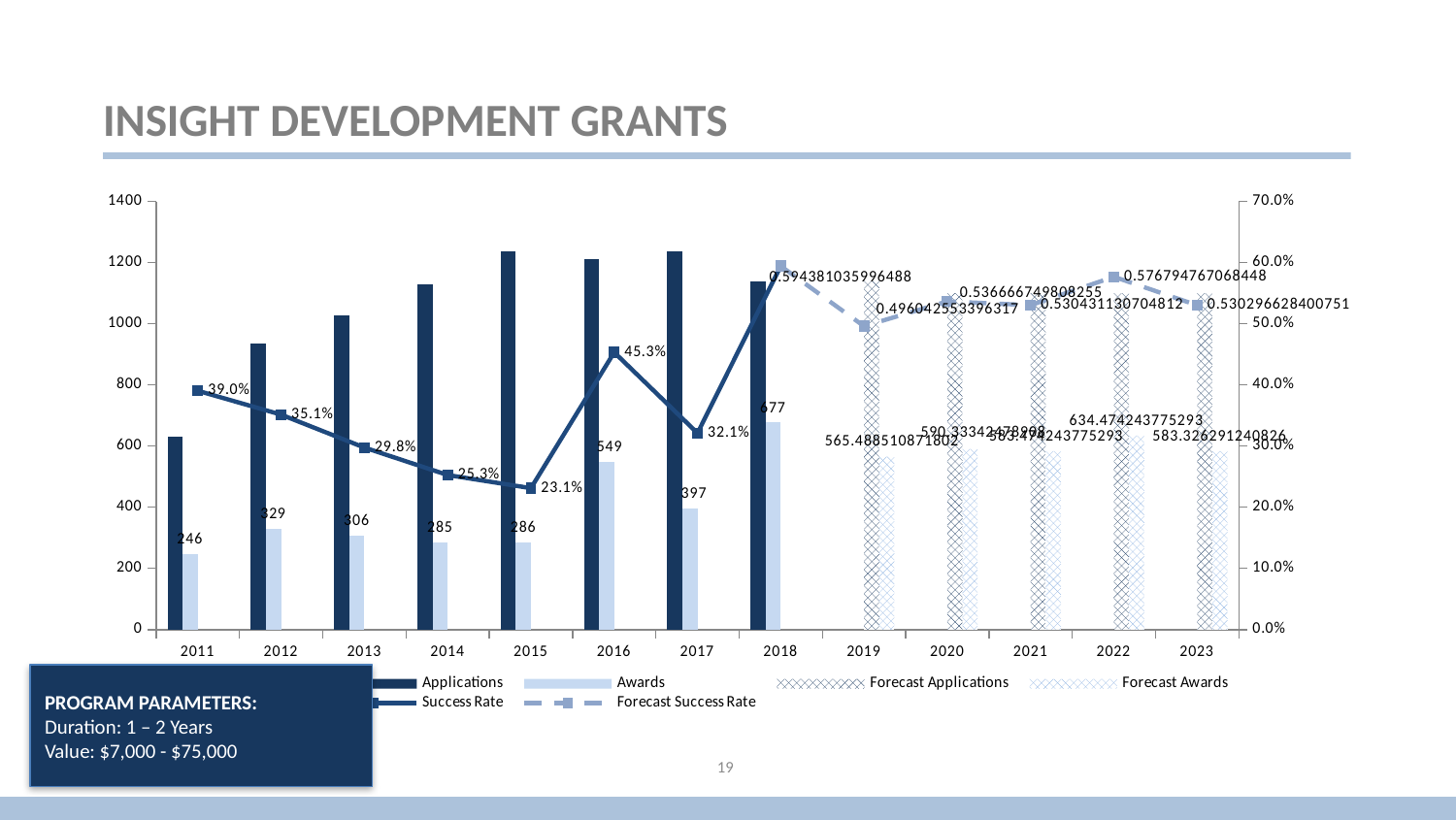
What is the difference between the Awards values for 2018 and 2017? 280 What is the Success Rate for 2016? 45.3% How many years are shown on the x axis? 13 Which year has the lowest Success Rate? 2015 Is the value for Applications in 2011 greater or less than 800? less What is the value for Awards in 2016? 549 Does the Success Rate rise or fall from 2011 to 2015? fall What is the Forecast Success Rate value shown for 2022? 0.576794767068448 What is the value for Awards in 2018? 677 Which year has the lowest Awards value? 2011 How many series does the legend list? 6 Which year has the larger Awards value, 2012 or 2013? 2012